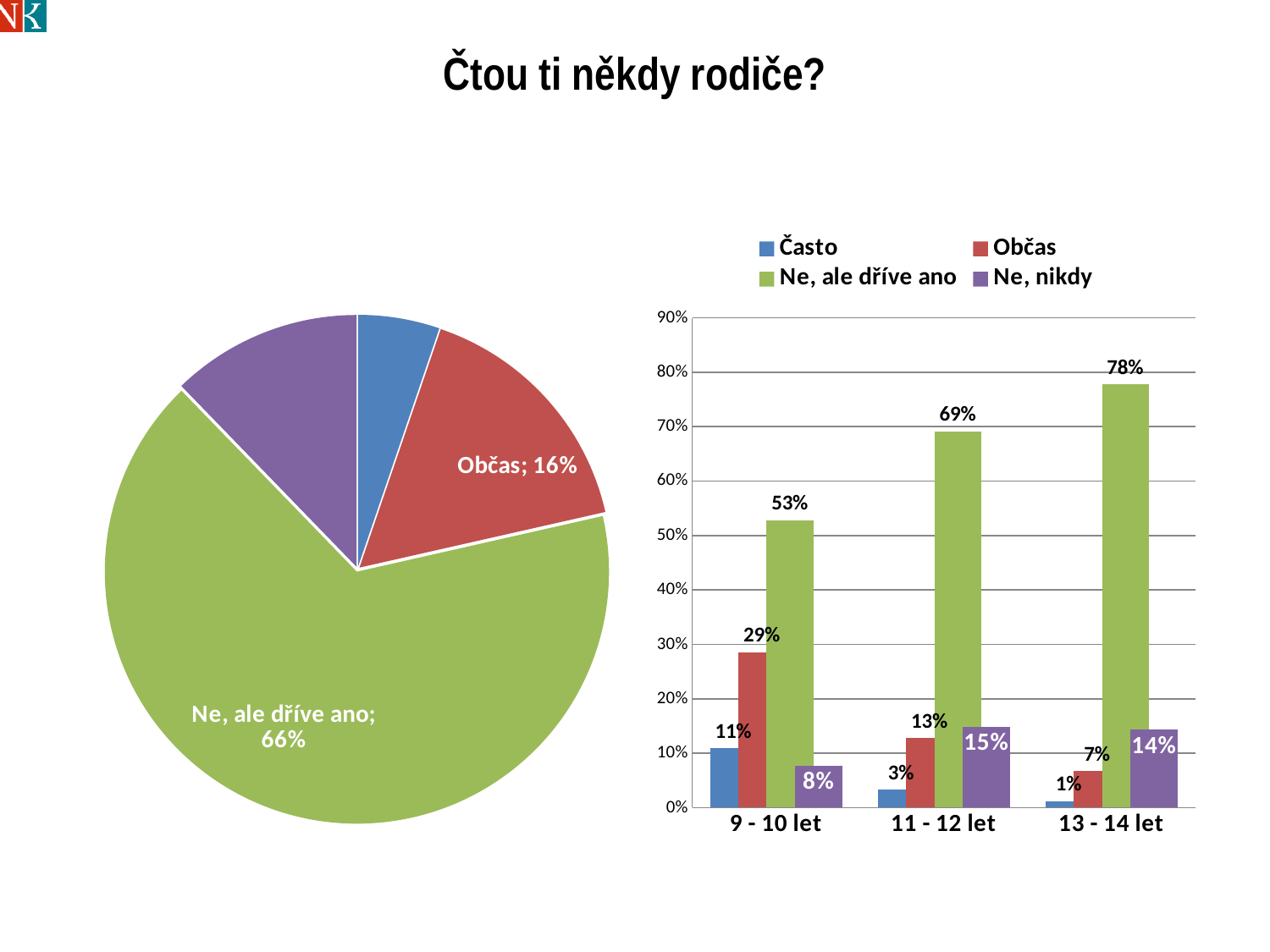
In the bar chart on the right, which age group has the highest value for 'Ne, ale dříve ano'? 13 - 14 let What kind of chart is shown on the left of the slide? pie chart In the bar chart on the right, how many age groups are shown on the x axis? 3 In the bar chart on the right, which age group has the lowest value for 'Často'? 13 - 14 let In the bar chart on the right, what is the difference between the 'Občas' values for '9 - 10 let' and '13 - 14 let'? 22% In the bar chart on the right, how many series does the legend list? 4 In the bar chart on the right, what is the value for 'Ne, nikdy' in the '11 - 12 let' group? 15% In the bar chart on the right, what is the value for 'Často' in the '9 - 10 let' group? 11% In the bar chart on the right, what is the value for 'Ne, ale dříve ano' in the '13 - 14 let' group? 78% In the bar chart on the right, is the 'Ne, nikdy' value larger for '9 - 10 let' or for '11 - 12 let'? 11 - 12 let In the pie chart on the left, what share does the 'Ne, ale dříve ano' slice have? 66% In the bar chart on the right, does the value for 'Často' rise or fall from '9 - 10 let' to '13 - 14 let'? fall